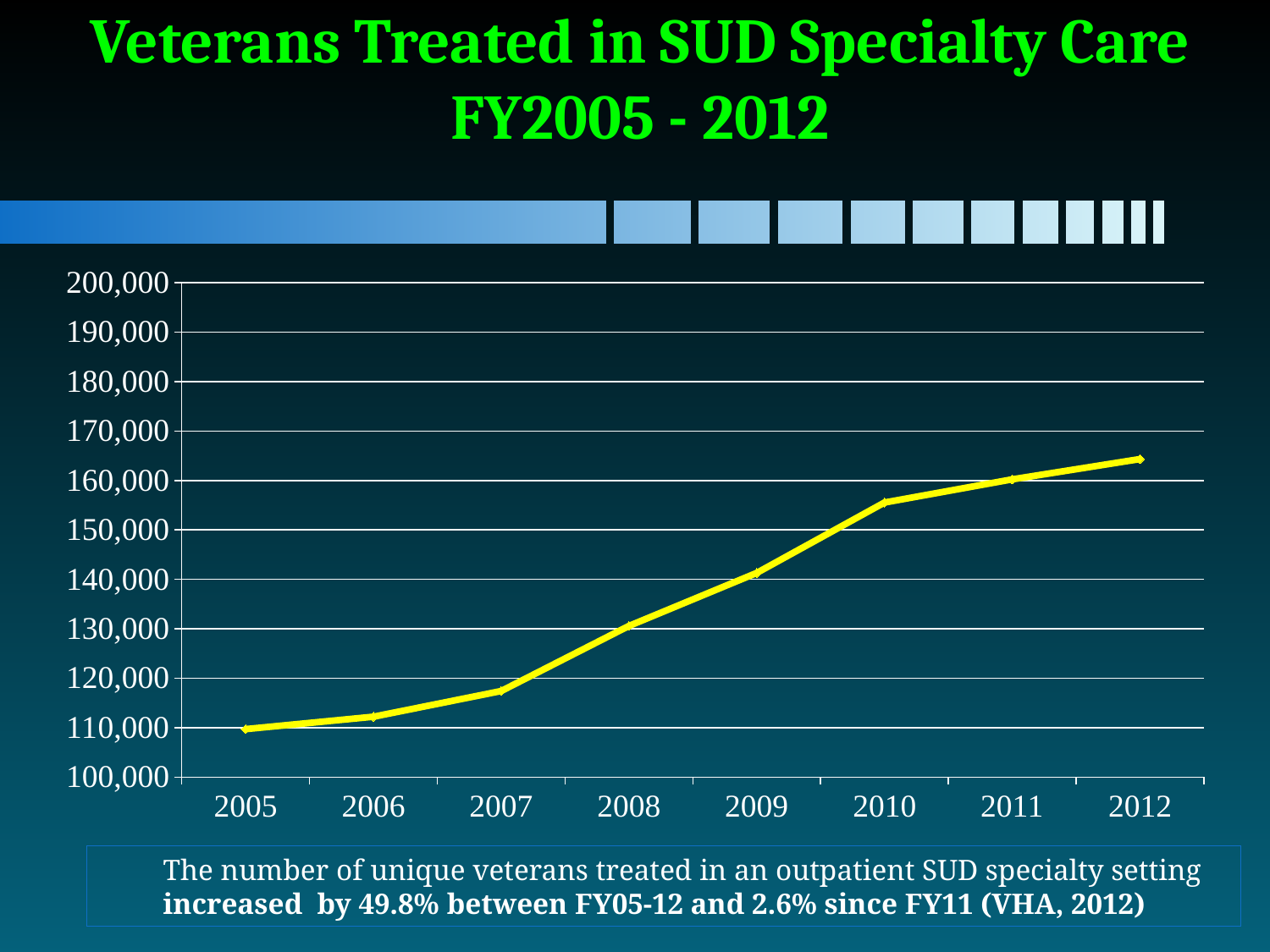
What colour is the plotted line in the chart? yellow Do the values rise or fall from 2005 to 2012? rise What is the title of the chart on the slide? Veterans Treated in SUD Specialty Care FY2005 - 2012 Is the value for 2007 greater or less than 120,000? less Is the value for 2012 greater or less than 160,000? greater Is the value for 2009 greater or less than 130,000? greater Which year has the lowest number of veterans treated in SUD specialty care? 2005 What kind of chart is shown on the slide? line chart How many years are plotted on the x axis of the chart? 8 Which year has a larger value, 2007 or 2010? 2010 Which year has the highest number of veterans treated in SUD specialty care? 2012